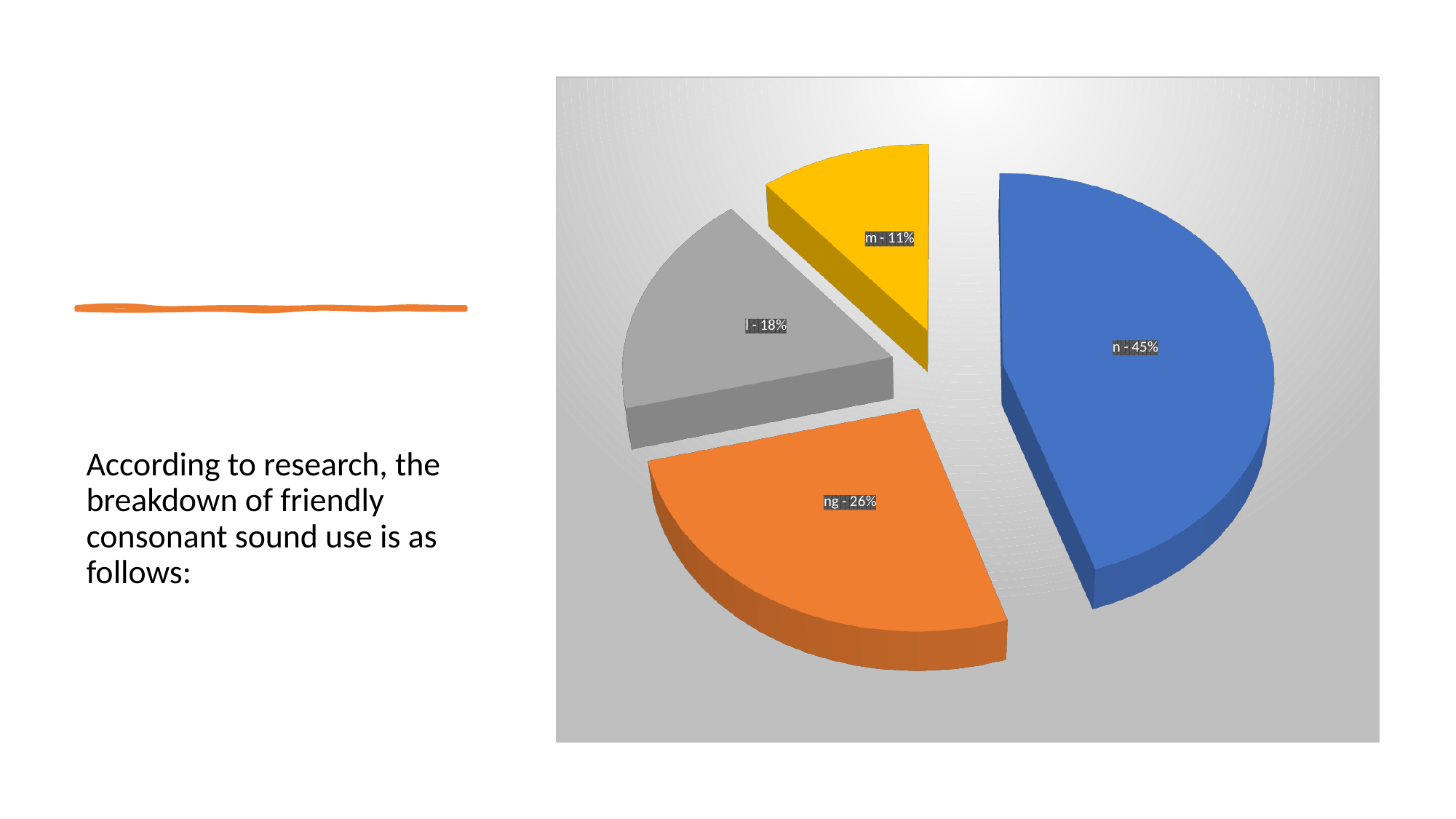
What share of the pie does the n slice represent? 45% What colour is the slice for ng? orange What kind of chart is shown on the slide? pie chart What is the difference in percentage points between the n slice and the ng slice? 19 What is the difference in percentage points between the l slice and the m slice? 7 How many slices does the pie chart have? 4 What share of the pie does the ng slice represent? 26% Which consonant sound has the smallest slice of the pie? m Which consonant sound has the largest slice of the pie? n What share of the pie does the l slice represent? 18% Which is larger, the l slice or the m slice? l What share of the pie does the m slice represent? 11%